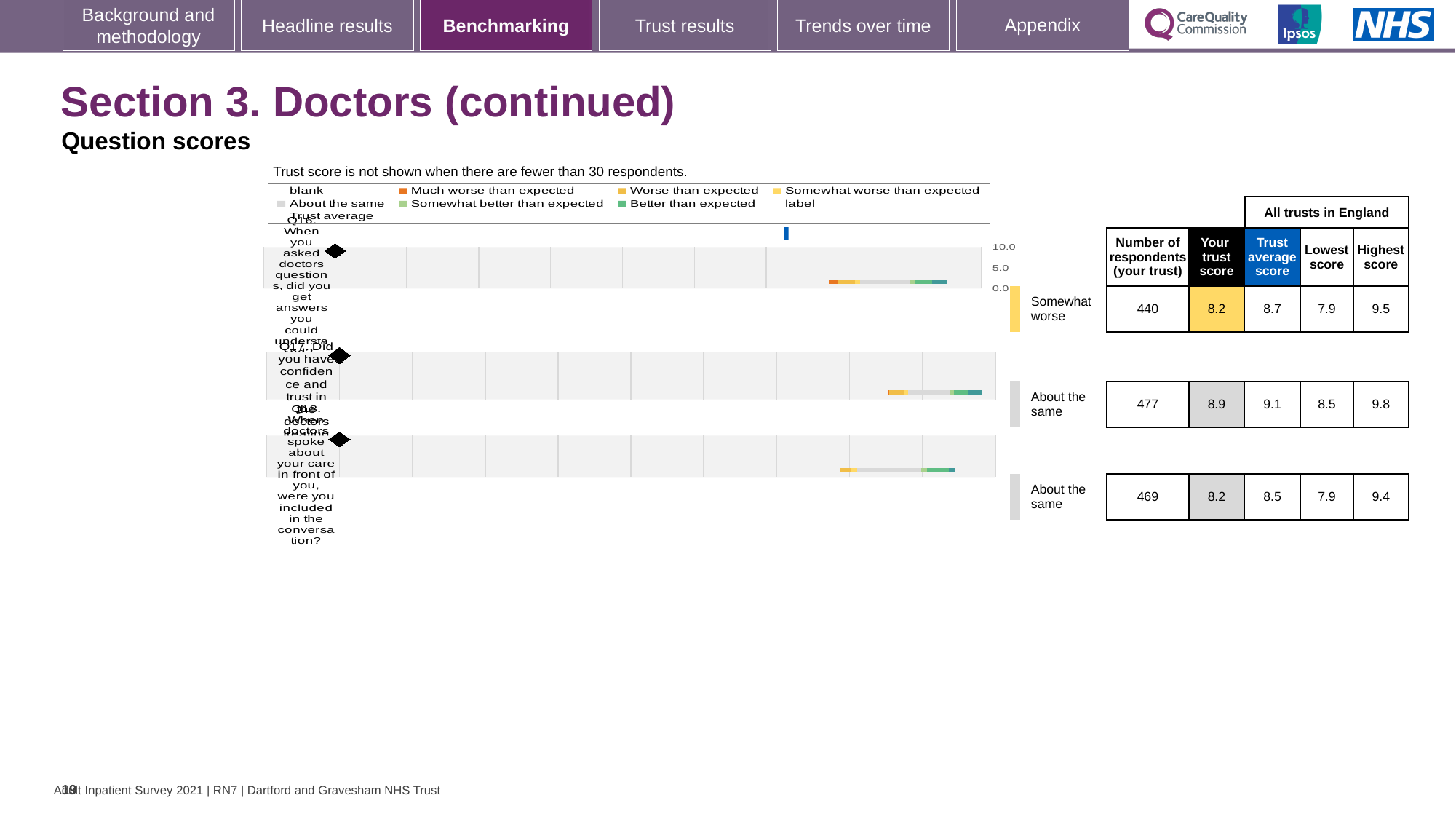
What is the maximum value shown on the chart's score axis? 10.0 What is the difference between the trust average score and your trust score for Q17? 0.2 What kind of chart is used to show the question scores on this slide? bar chart What benchmark category is shown for Q16? Somewhat worse What is the 'Your trust score' for Q17? 8.9 What is the highest score across all trusts in England for Q16? 9.5 Which question has the highest 'Your trust score'? Q17 How many questions (rows) are plotted in the chart? 3 What is the trust average score for Q18? 8.5 What is the number of respondents (your trust) for Q16? 440 For Q16, which is larger: your trust score or the trust average score? Trust average score What is the lowest score across all trusts in England for Q17? 8.5